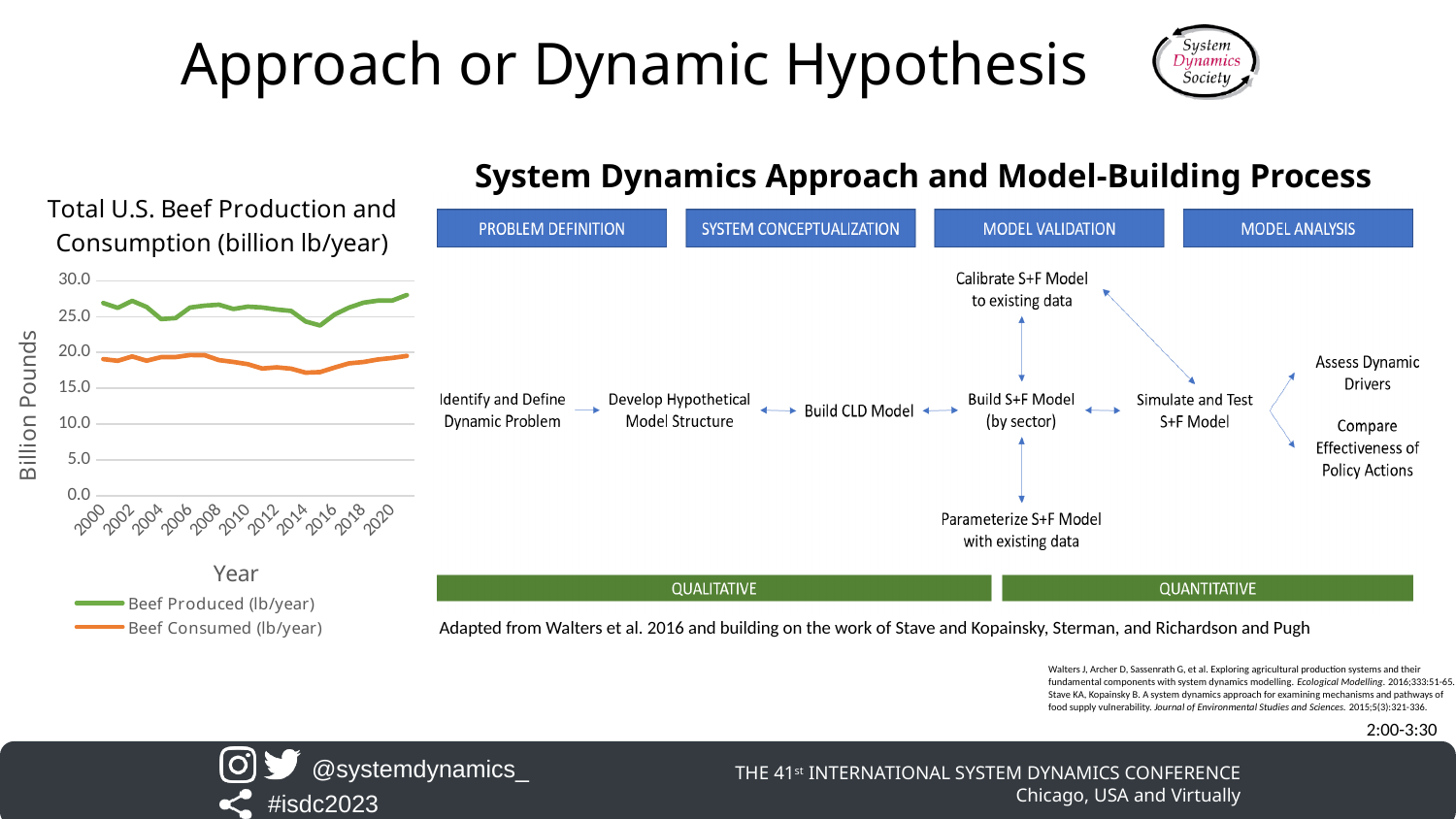
What is the label on the vertical axis of the chart? Billion Pounds Is the value for Beef Produced (lb/year) in 2000 greater or less than 25.0? greater What is the title of the chart? Total U.S. Beef Production and Consumption (billion lb/year) Is the value for Beef Consumed (lb/year) in 2020 greater or less than 15.0? greater Does the Beef Produced (lb/year) line rise or fall between 2016 and 2020? Rise How many series does the chart legend list? 2 Is the value for Beef Produced (lb/year) in 2020 greater or less than 25.0? greater How many year labels are shown on the x axis of the chart? 11 Which series has the larger value in 2010, Beef Produced (lb/year) or Beef Consumed (lb/year)? Beef Produced (lb/year) Does the Beef Consumed (lb/year) line rise or fall between 2008 and 2014? Fall What kind of chart is shown on the slide? Line chart